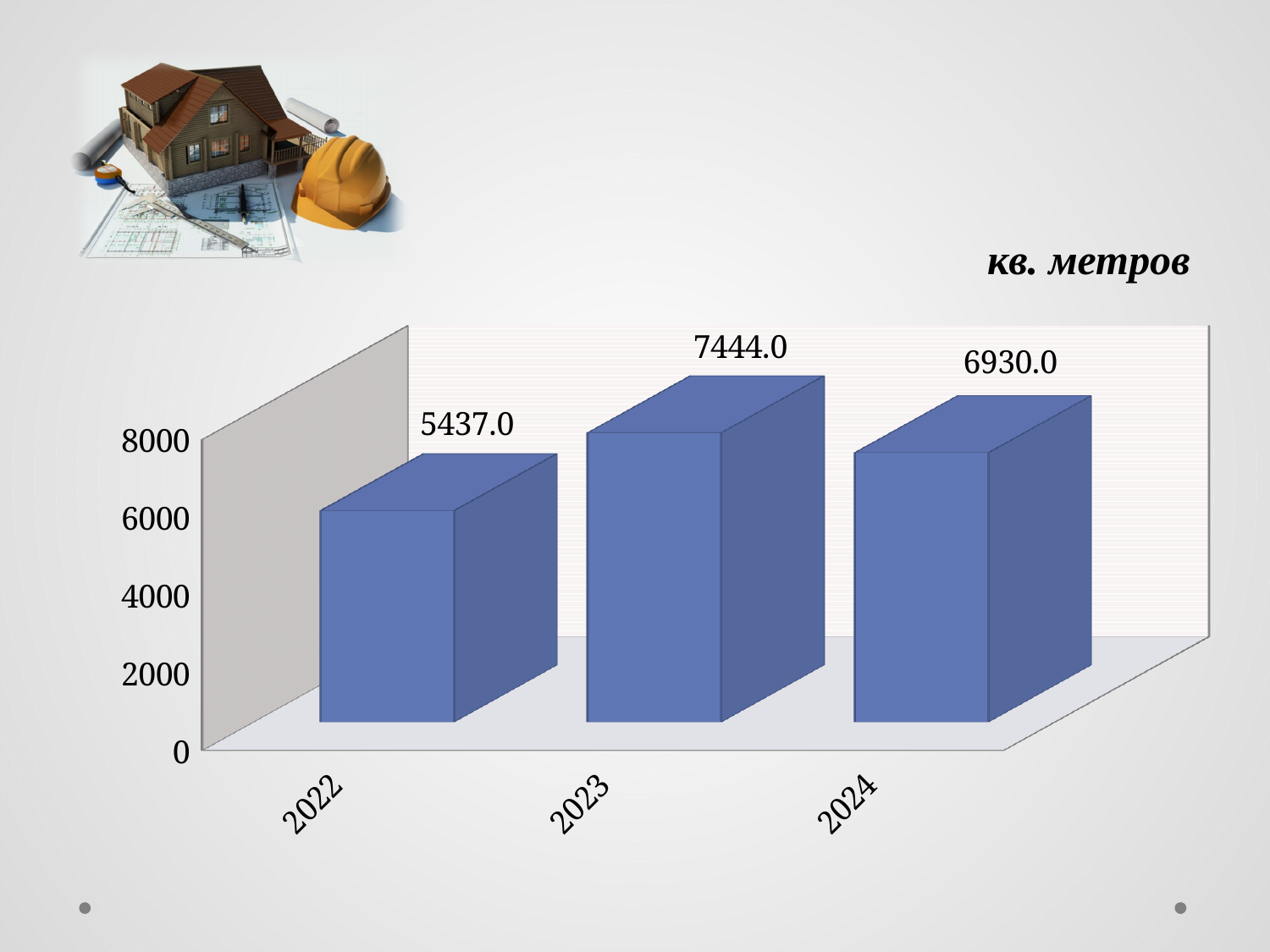
What is the difference between the values for 2023 and 2022? 2007.0 What kind of chart is shown on the slide? bar chart What unit label is shown above the chart? кв. метров What is the value for 2024? 6930.0 How many years are shown on the x axis? 3 Which year has the highest value? 2023 What is the difference between the values for 2023 and 2024? 514.0 What is the value for 2023? 7444.0 Which is larger, the value for 2024 or the value for 2022? 2024 Is the value for 2022 greater or less than 6000? less What is the value for 2022? 5437.0 Which year has the lowest value? 2022